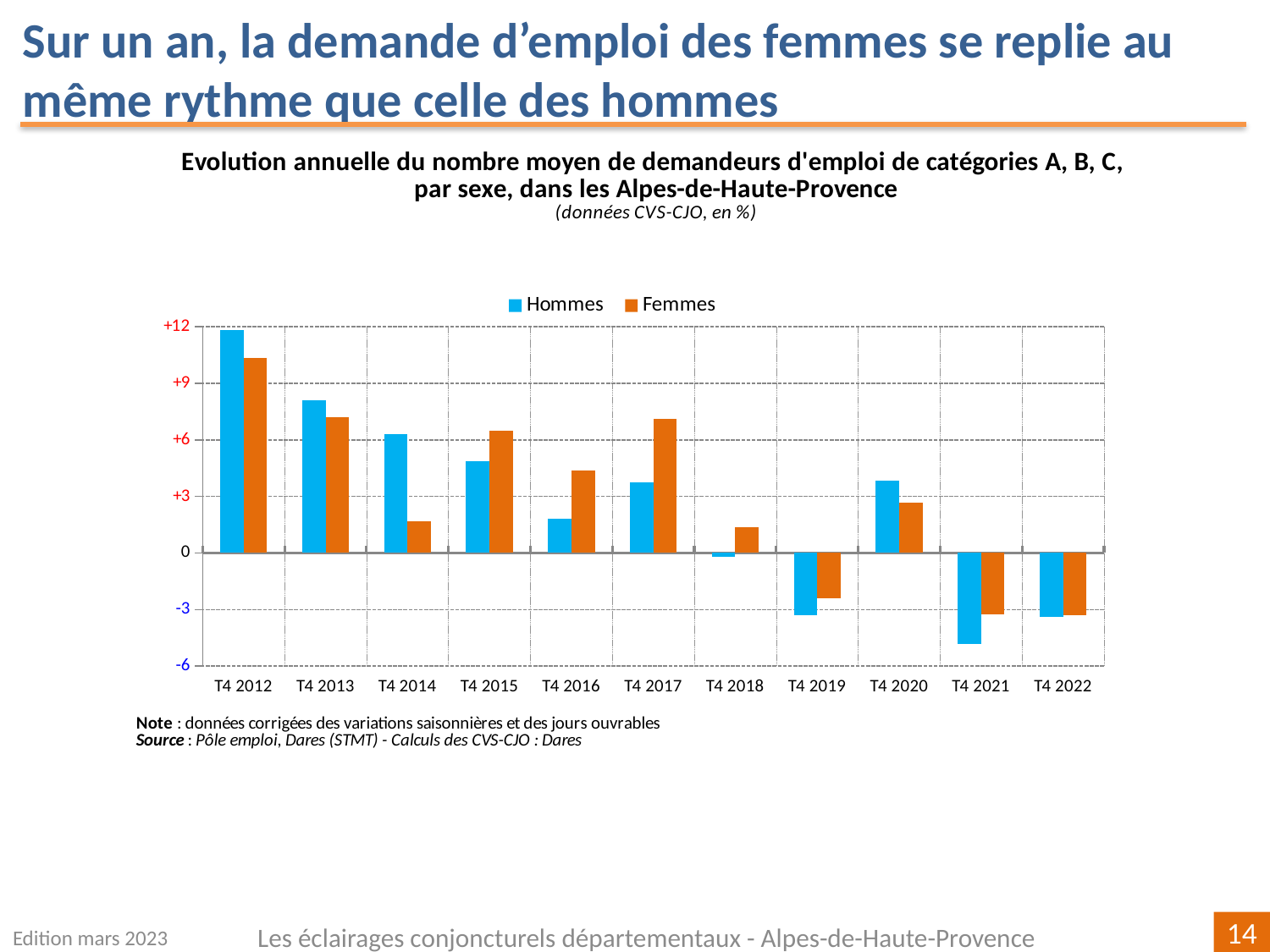
How many quarters (categories) are shown on the x axis? 11 In which quarter is the value for Hommes the lowest? T4 2021 Which colour represents the Hommes series in the legend? blue Is the value for Femmes in T4 2014 greater or less than +3? less What kind of chart is shown on the slide? bar chart In T4 2017, which series has the larger value, Hommes or Femmes? Femmes In which quarter is the value for Femmes the highest? T4 2012 Is the value for Hommes in T4 2021 greater or less than -3? less In T4 2014, which series has the larger value, Hommes or Femmes? Hommes Is the value for Hommes in T4 2012 greater or less than +9? greater How many series does the legend list? 2 In which quarter is the value for Hommes the highest? T4 2012